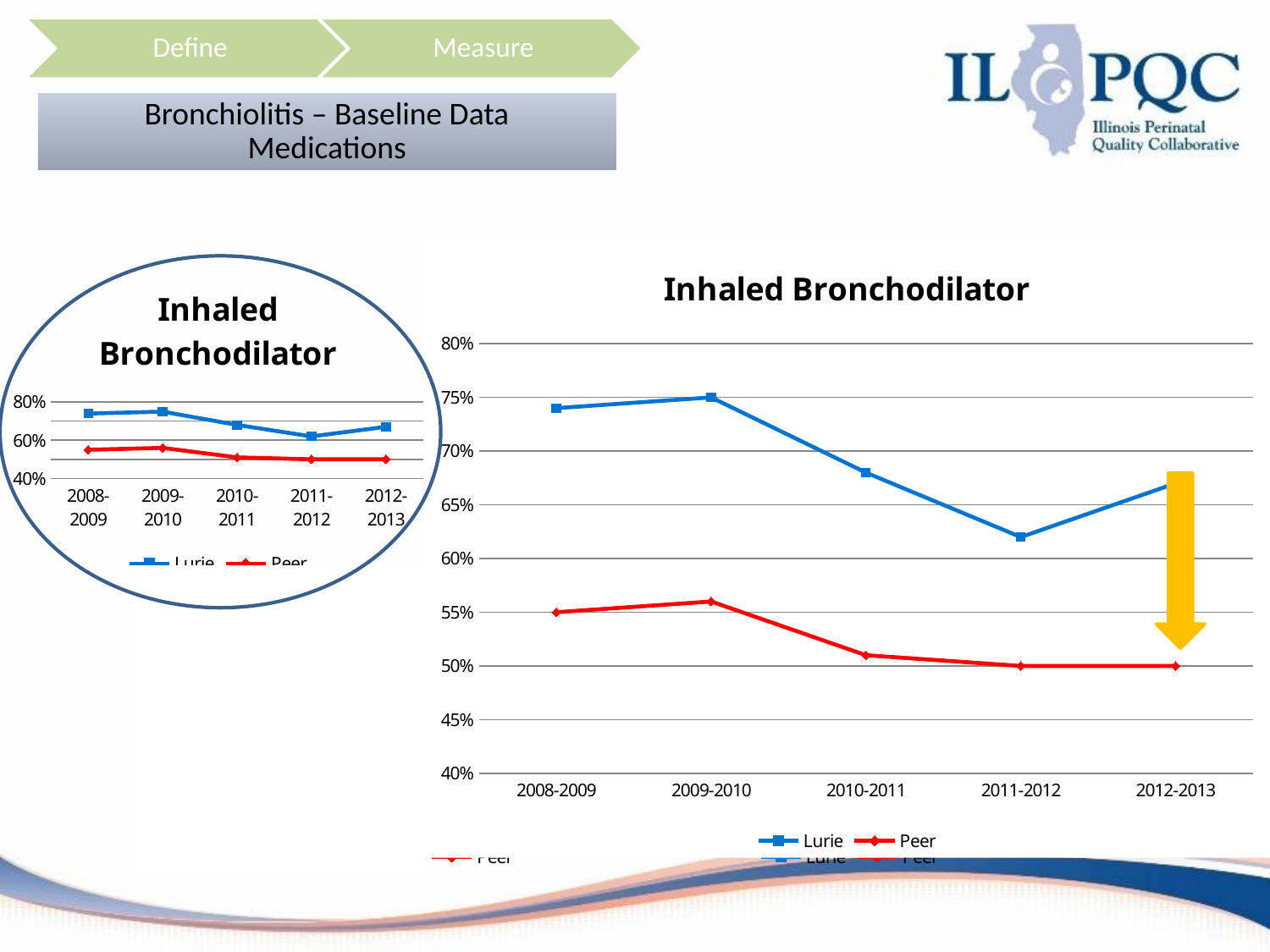
On the large chart on the right, is the Peer value for 2010-2011 greater or less than 55%? less On the large chart on the right, is the Lurie value for 2011-2012 greater or less than 65%? less On the large chart on the right, which series has the higher value in 2012-2013, Lurie or Peer? Lurie On the large chart on the right, in which period is the Peer value highest? 2009-2010 On the large chart on the right, what type of chart is shown? line chart On the large chart on the right, does the Peer series generally rise or fall from 2009-2010 to 2012-2013? fall On the large chart on the right, how many time periods are shown on the x axis? 5 On the large chart on the right, what is the title of the chart? Inhaled Bronchodilator On the large chart on the right, in which period is the Lurie value lowest? 2011-2012 On the large chart on the right, is the Lurie value for 2008-2009 greater or less than 70%? greater On the large chart on the right, which series is drawn in red? Peer On the large chart on the right, how many series does the legend list? 2